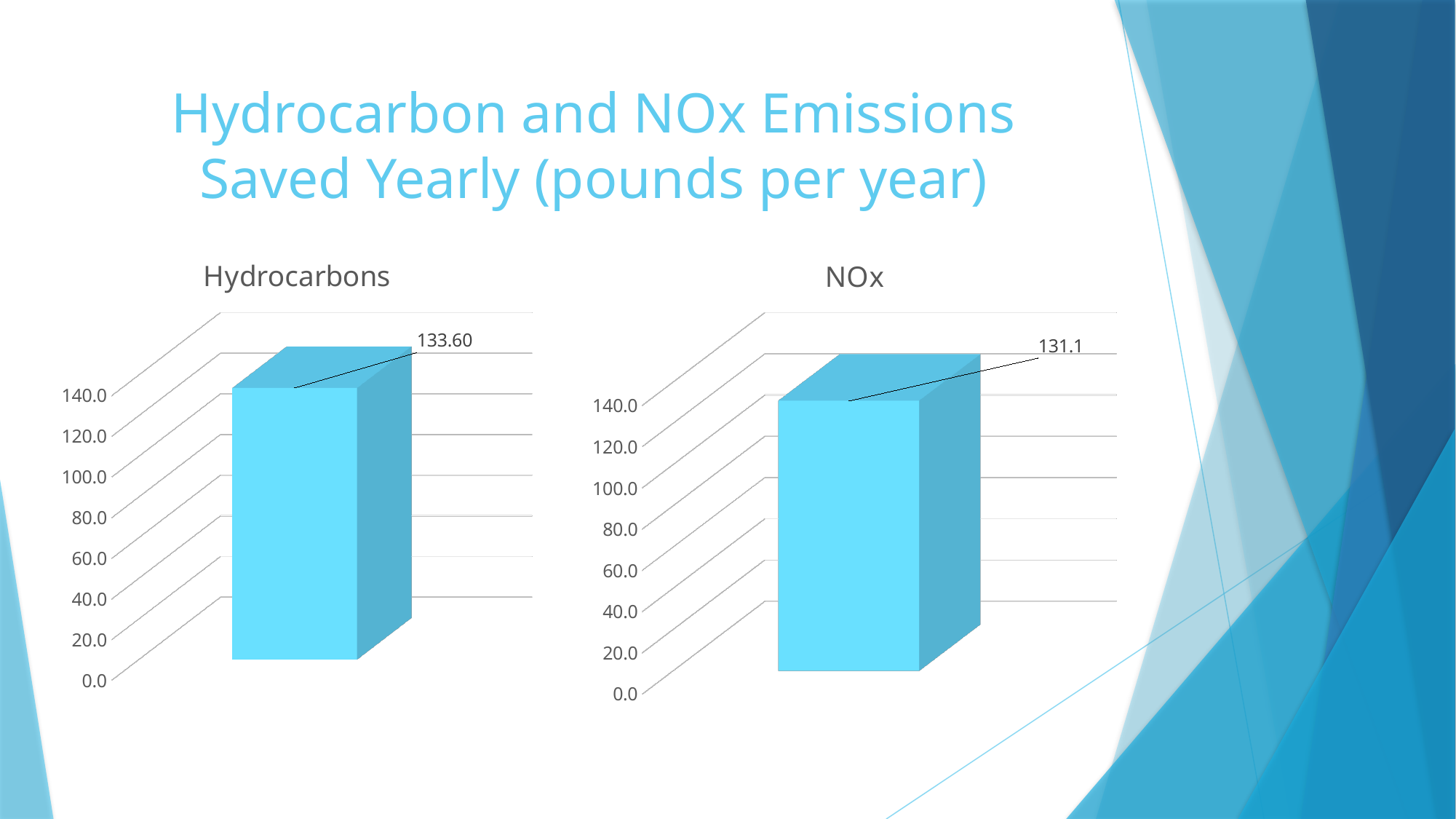
Which is larger, the Hydrocarbons value (133.60) or the NOx value (131.1)? Hydrocarbons How many bars are plotted in the Hydrocarbons chart? 1 What kind of chart is the Hydrocarbons chart? bar chart In the NOx chart, is the value of the bar greater or less than 140.0? less What is the difference between the Hydrocarbons value (133.60) and the NOx value (131.1)? 2.5 What is the highest tick value shown on the vertical axis of the NOx chart? 140.0 What kind of chart is the NOx chart? bar chart In the NOx chart, what value is shown on the bar's data label? 131.1 In the Hydrocarbons chart, what value is shown on the bar's data label? 133.60 In the Hydrocarbons chart, is the value of the bar greater or less than 120.0? greater How many bars are plotted in the NOx chart? 1 What is the title of the chart on the left side of the slide? Hydrocarbons